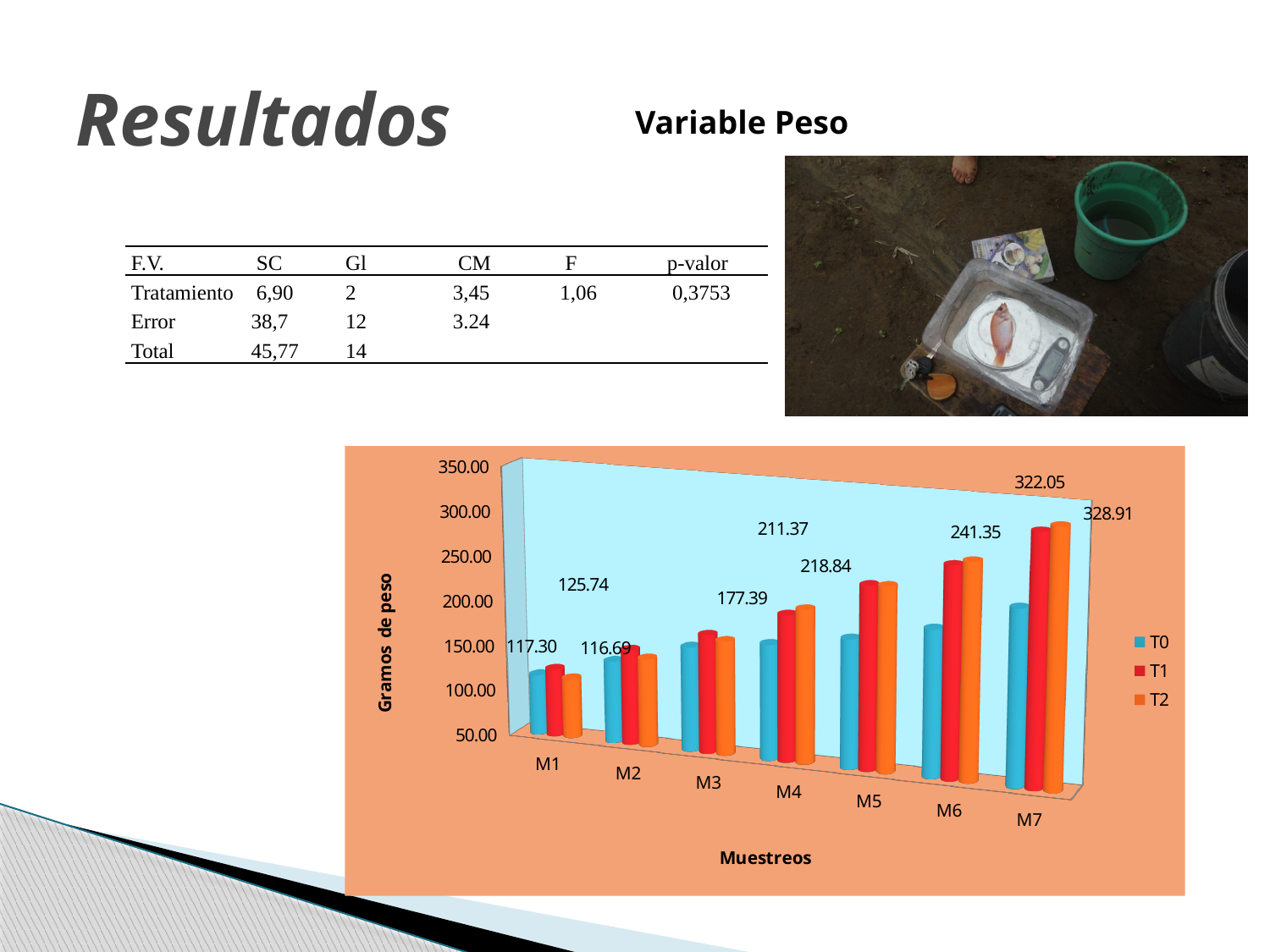
What kind of chart is shown on the slide? bar chart Is the value for T1 at M7 greater or less than 250.00? greater What is the label of the vertical axis of the chart? Gramos de peso What are the names of the series listed in the chart legend? T0, T1, T2 How many series does the legend of the chart list? 3 Do the weight values generally rise or fall from M1 to M7 in the chart? rise Which category (muestreo) has the tallest bars in the chart? M7 Which is larger in the chart, the T2 value at M6 or the T2 value at M2? T2 at M6 How many categories (muestreos) are shown on the x axis of the chart? 7 Which is larger in the chart, the T0 value at M7 or the T0 value at M1? T0 at M7 Is the value for T0 at M7 greater or less than 150.00? greater Is the value for T0 at M1 greater or less than 150.00? less